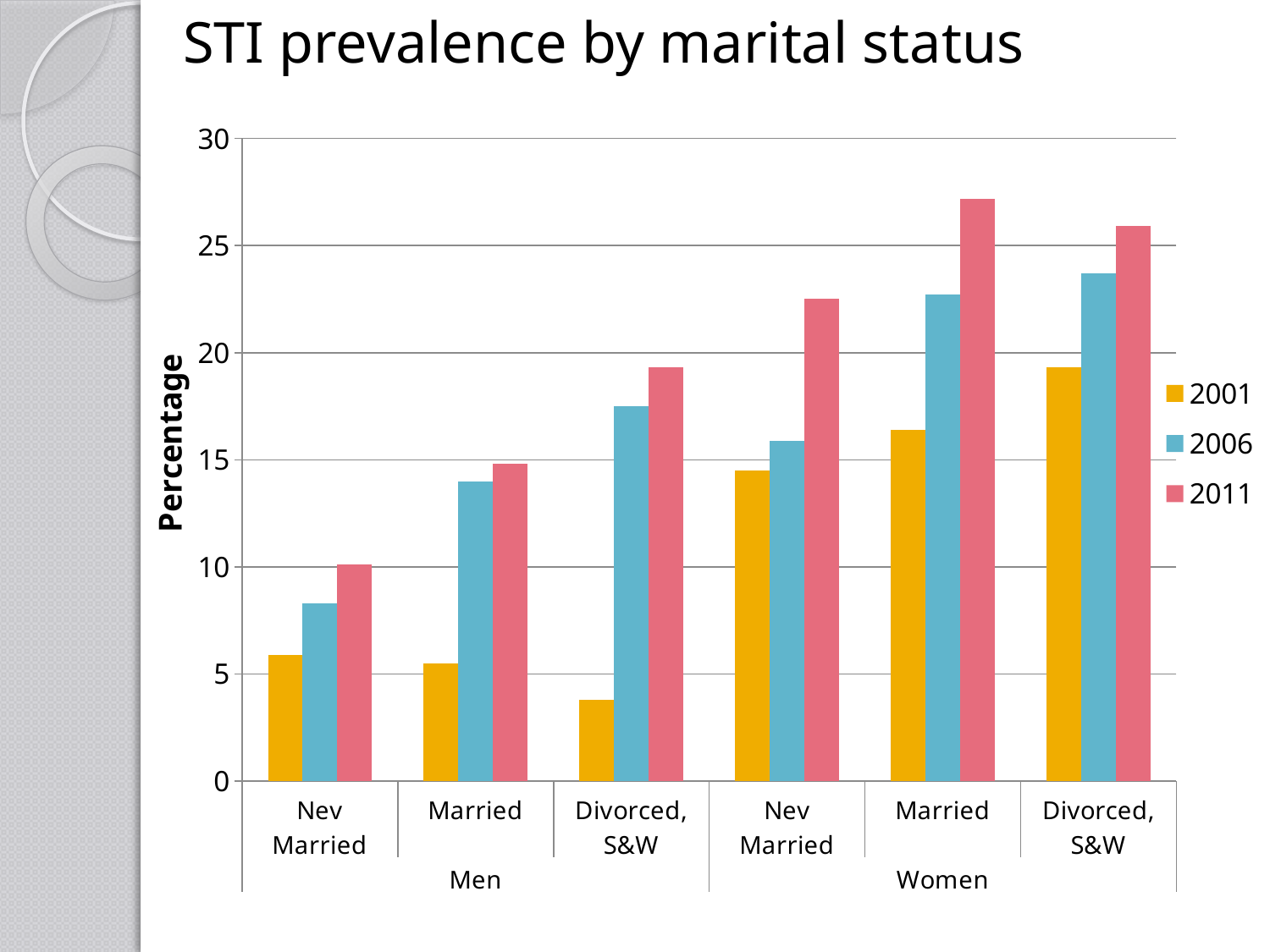
Which bar is the lowest in the chart? 2001 for Divorced, S&W men What is the label on the vertical axis? Percentage For 2006, which is larger: the value for Married men or for Divorced, S&W men? Divorced, S&W men Is the 2006 value for Nev Married men greater or less than 10? less Within each marital-status group, do the values rise or fall from 2001 to 2011? rise Is the 2001 value for Married men greater or less than 10? less How many marital-status categories are plotted along the x axis? 6 Is the 2011 value for Married women greater or less than 25? greater What kind of chart is shown on the slide? bar chart For 2011, which is larger: the value for Nev Married women or for Divorced, S&W women? Divorced, S&W women Which bar is the highest in the chart? 2011 for Married women How many series does the legend list? 3